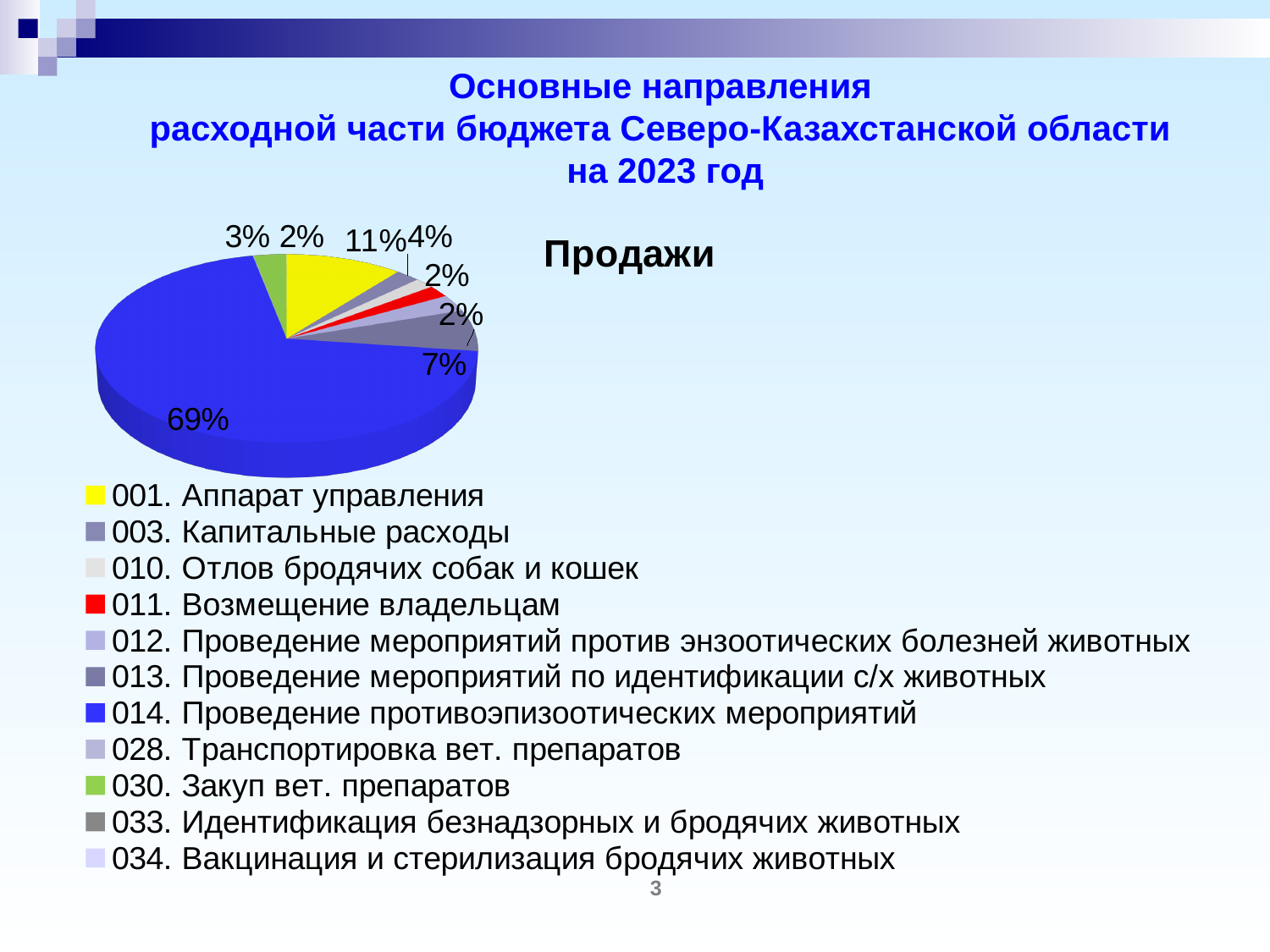
Is the share for "014. Проведение противоэпизоотических мероприятий" greater or less than 50%? greater What kind of chart is shown on the slide? pie chart Which is larger: the share for "001. Аппарат управления" or for "014. Проведение противоэпизоотических мероприятий"? 014. Проведение противоэпизоотических мероприятий What colour is the slice for "014. Проведение противоэпизоотических мероприятий"? blue What is the title of the chart? Продажи How many categories does the chart legend list? 11 By how many percentage points does the share of "014. Проведение противоэпизоотических мероприятий" exceed that of "001. Аппарат управления"? 58 What share of the pie does "030. Закуп вет. препаратов" have? 3% Which is larger: the share for "030. Закуп вет. препаратов" or for "001. Аппарат управления"? 001. Аппарат управления What share of the pie does "001. Аппарат управления" have? 11% What share of the pie does "014. Проведение противоэпизоотических мероприятий" have? 69% Which category has the largest share of the pie? 014. Проведение противоэпизоотических мероприятий